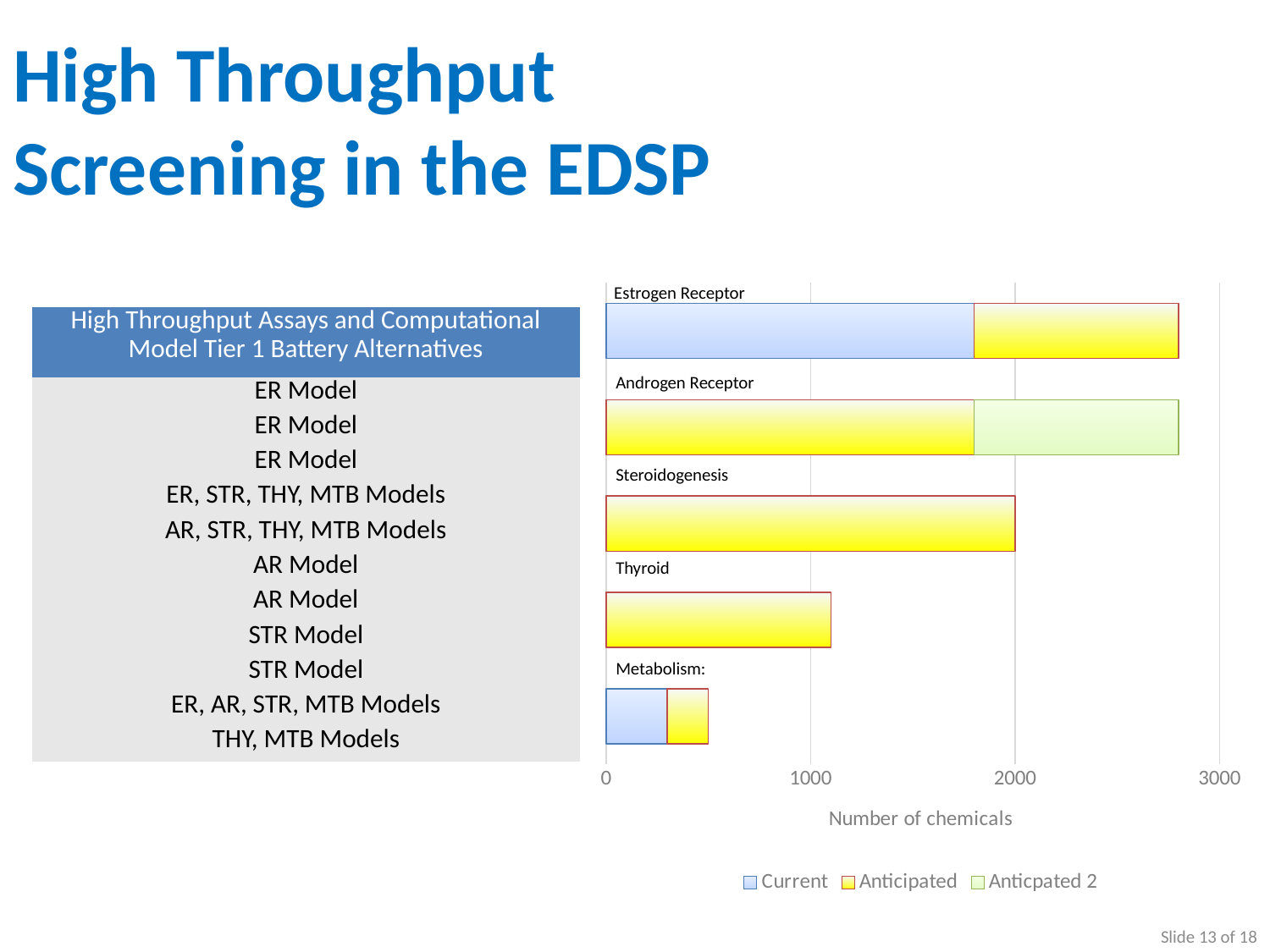
What are the three entries in the chart legend? Current, Anticipated, Anticpated 2 Is the total value for Thyroid greater or less than 1000? greater Is the total value for Thyroid greater or less than 2000? less How many series does the chart legend list? 3 How many categories are plotted in the chart? 5 What kind of chart is shown on the slide? Bar chart Which has the larger total bar, Steroidogenesis or Thyroid? Steroidogenesis Which category has the shortest total bar? Metabolism Which has the larger total bar, Metabolism or Thyroid? Thyroid Is the total value for Estrogen Receptor greater or less than 2000? greater What is the title of the chart's horizontal axis? Number of chemicals